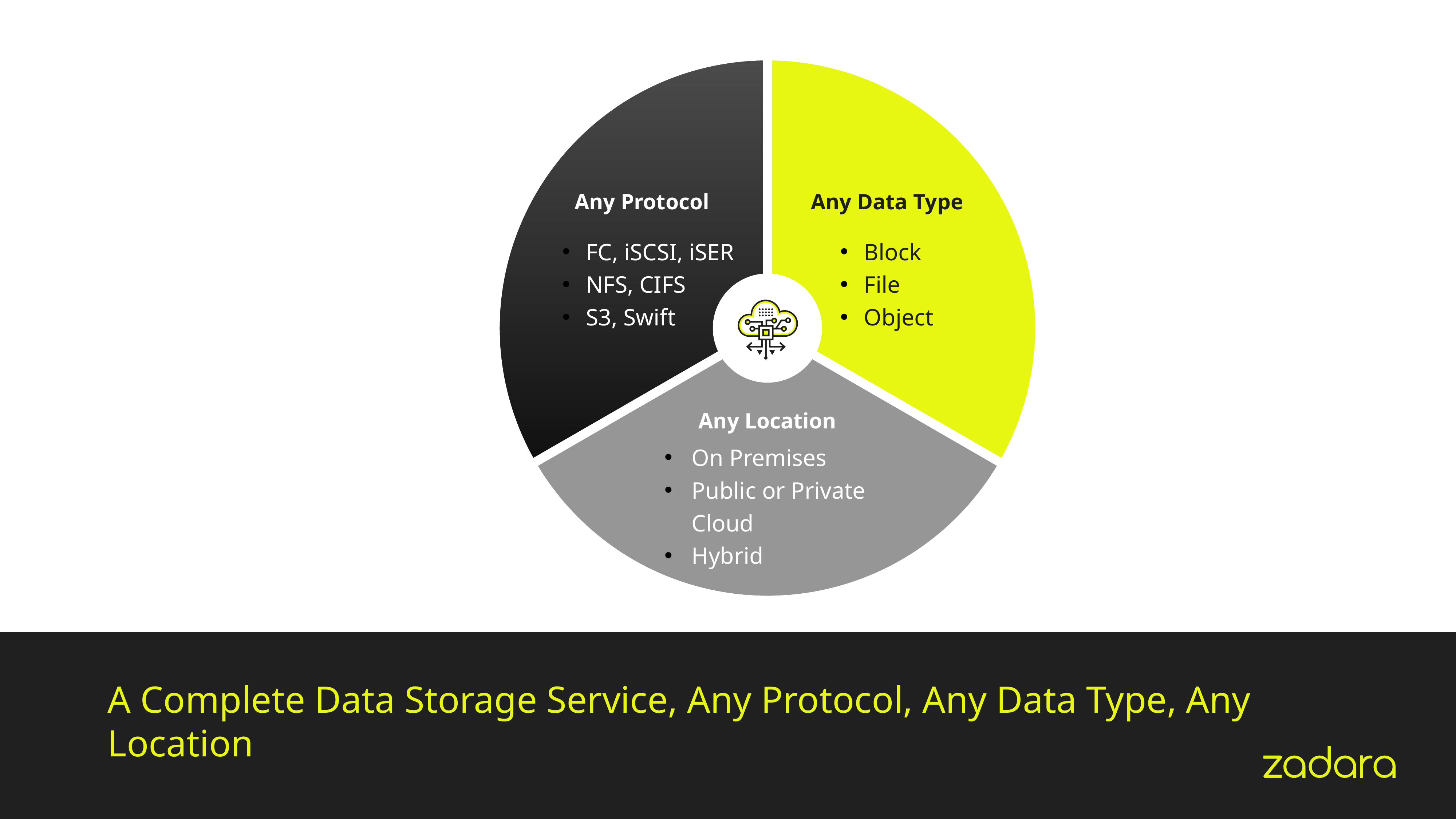
Which segment of the diagram is coloured yellow? Any Data Type What items are listed under the Any Location segment? On Premises, Public or Private Cloud, Hybrid Which segment of the diagram is coloured grey, at the bottom? Any Location What kind of chart is shown on the slide? pie chart What items are listed under the Any Data Type segment? Block, File, Object What items are listed under the Any Protocol segment? FC, iSCSI, iSER; NFS, CIFS; S3, Swift How many segments does the circular diagram have? 3